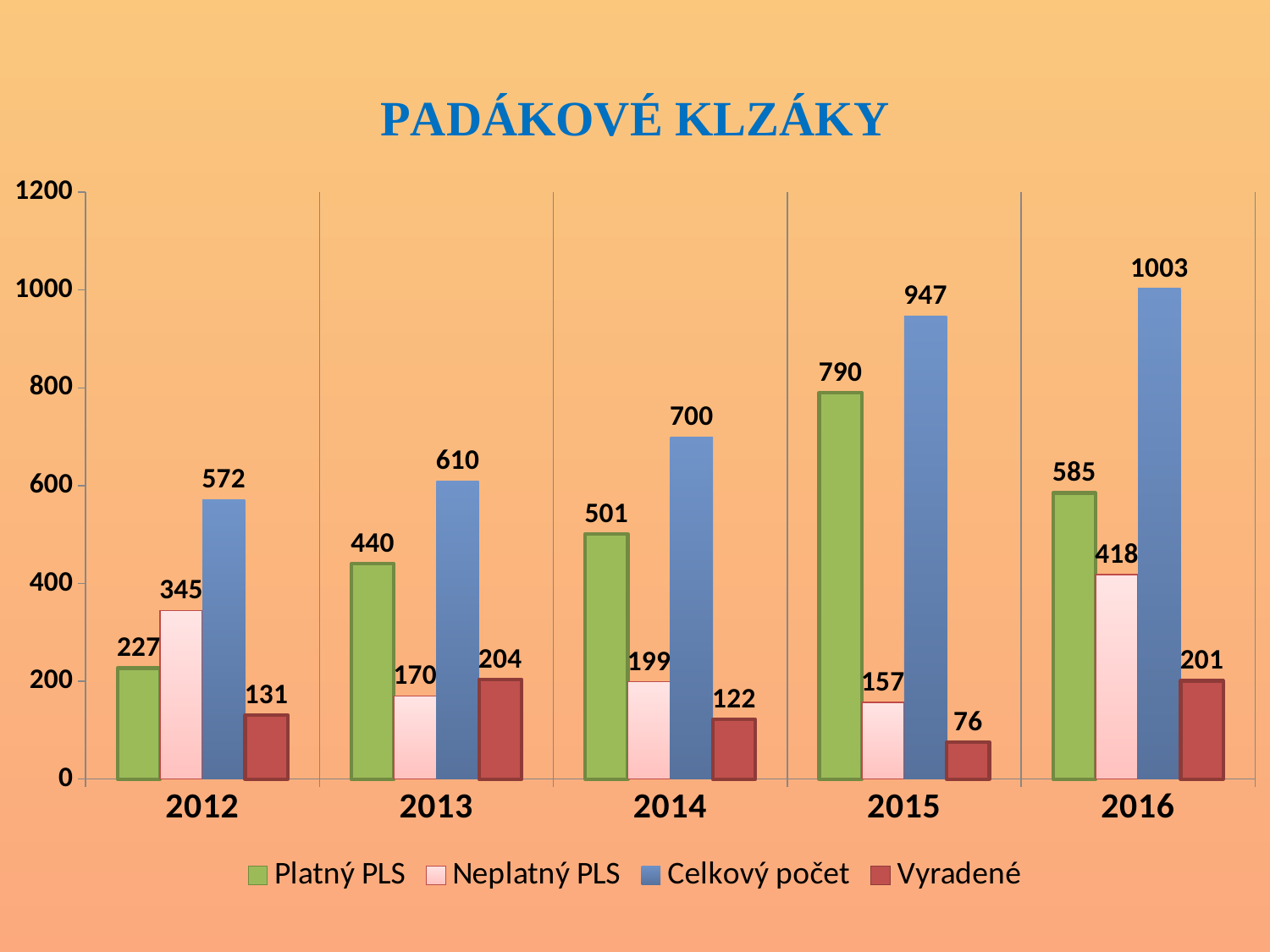
What is the value of Vyradené for 2014? 122 What kind of chart is shown? bar chart How many years are shown on the x axis? 5 What is the value of Neplatný PLS for 2012? 345 What is the value of Celkový počet for 2016? 1003 How many series does the legend list? 4 In which year is Vyradené lowest? 2015 In which year is Celkový počet highest? 2016 What is the value of Platný PLS for 2015? 790 What is the difference between Celkový počet in 2016 and in 2015? 56 Which is larger: Platný PLS in 2016 or Platný PLS in 2015? Platný PLS in 2015 What is the title of the chart? PADÁKOVÉ KLZÁKY